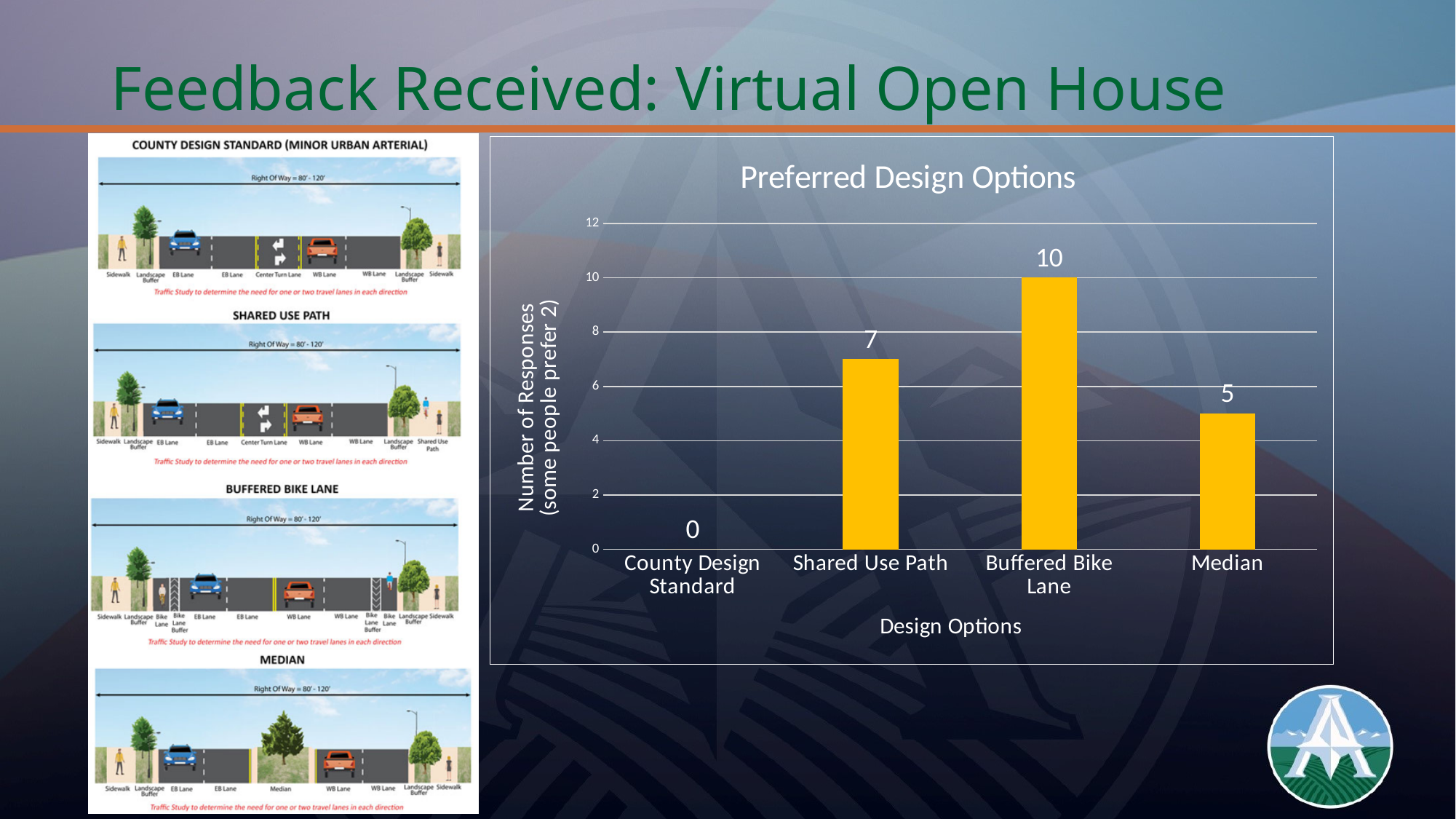
Which design option received the fewest responses? County Design Standard Which received more responses, Shared Use Path or Median? Shared Use Path What is the number of responses for Shared Use Path? 7 What is the number of responses for Buffered Bike Lane? 10 What is the difference in responses between Buffered Bike Lane and Shared Use Path? 3 What type of chart is used to show the preferred design options? Bar chart Which design option received the most responses? Buffered Bike Lane What is the title of the chart? Preferred Design Options What is the number of responses for Median? 5 What is the number of responses for County Design Standard? 0 How many design options are shown on the chart? 4 Is the value for Buffered Bike Lane greater or less than 8? greater